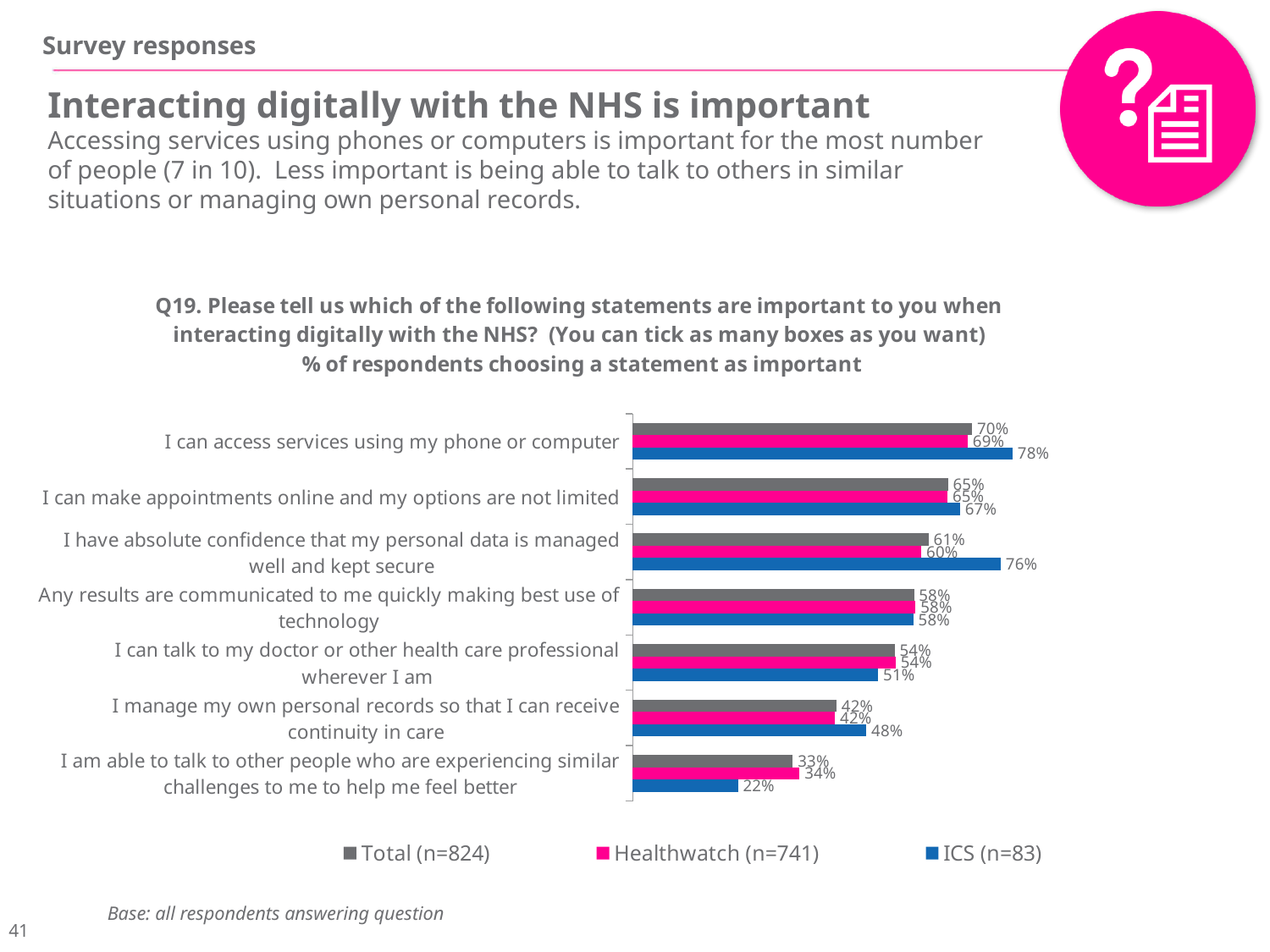
What is the Total (n=824) value for 'I have absolute confidence that my personal data is managed well and kept secure'? 61% What is the ICS (n=83) value for 'I can access services using my phone or computer'? 78% What is the difference between the ICS (n=83) and Total (n=824) values for 'I have absolute confidence that my personal data is managed well and kept secure'? 15% How many statements (categories) are plotted in the chart? 7 Which series is shown in blue in the legend? ICS (n=83) What kind of chart is shown on the slide? Bar chart What is the Total (n=824) value for 'Any results are communicated to me quickly making best use of technology'? 58% Which statement has the lowest ICS (n=83) value? I am able to talk to other people who are experiencing similar challenges to me to help me feel better How many series does the legend list? 3 For 'I manage my own personal records so that I can receive continuity in care', which is larger: the ICS (n=83) value or the Total (n=824) value? ICS (n=83) What is the Healthwatch (n=741) value for 'I am able to talk to other people who are experiencing similar challenges to me to help me feel better'? 34% Which statement has the highest Total (n=824) value? I can access services using my phone or computer